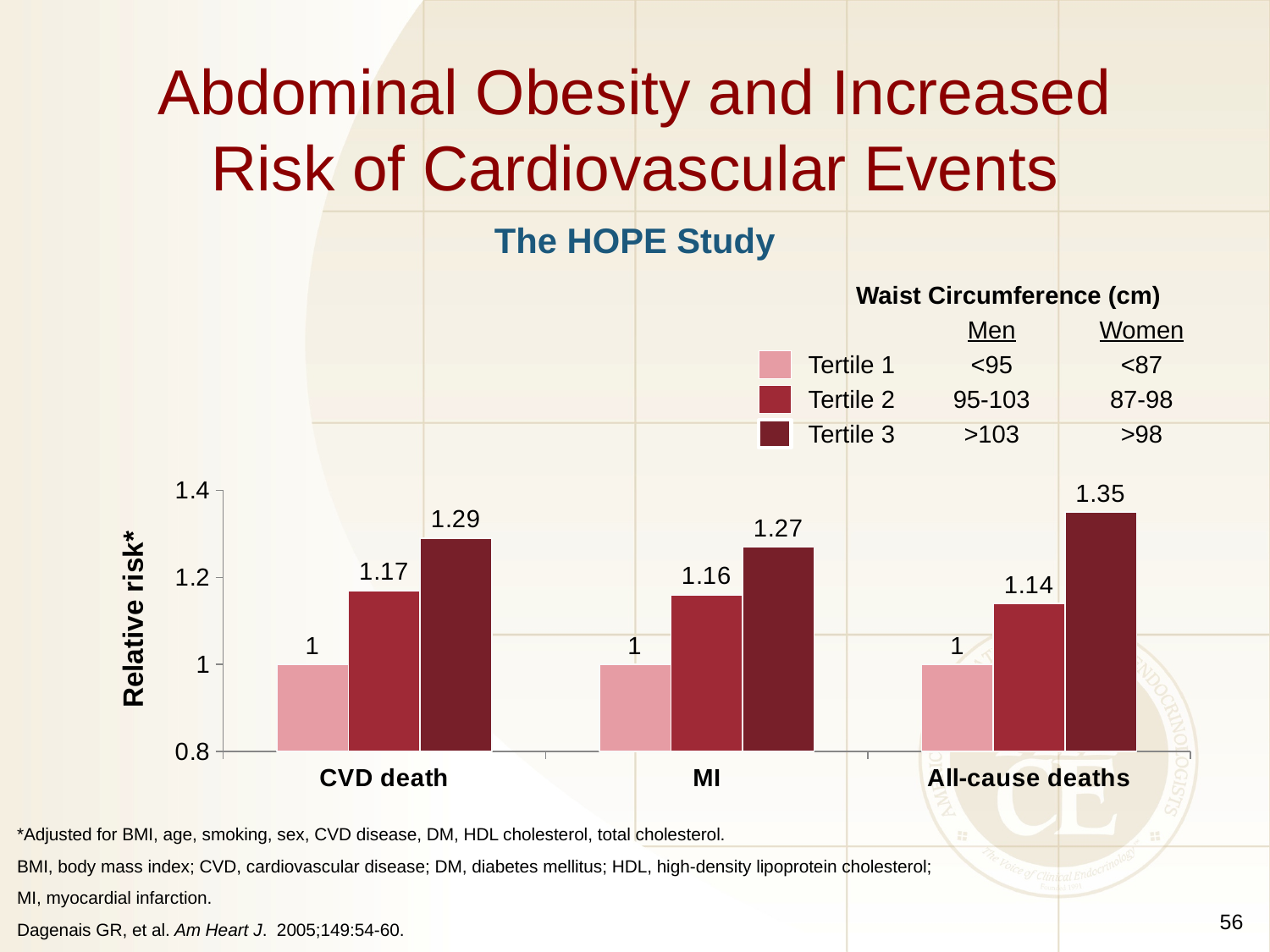
What kind of chart is shown on the slide? Bar chart Is the Tertile 3 relative risk for MI greater or less than 1.2? greater What is the relative risk for Tertile 3 in the CVD death category? 1.29 How many series does the legend list? 3 How many categories are shown on the x axis? 3 Which category has the highest Tertile 3 relative risk? All-cause deaths What is the relative risk for Tertile 2 in the MI category? 1.16 What is the relative risk for Tertile 1 in the MI category? 1 Which category has the lowest Tertile 2 relative risk? All-cause deaths What is the relative risk for Tertile 3 in the All-cause deaths category? 1.35 Which is larger: the Tertile 2 relative risk for CVD death or for MI? CVD death What is the difference between the Tertile 3 and Tertile 1 relative risk for All-cause deaths? 0.35